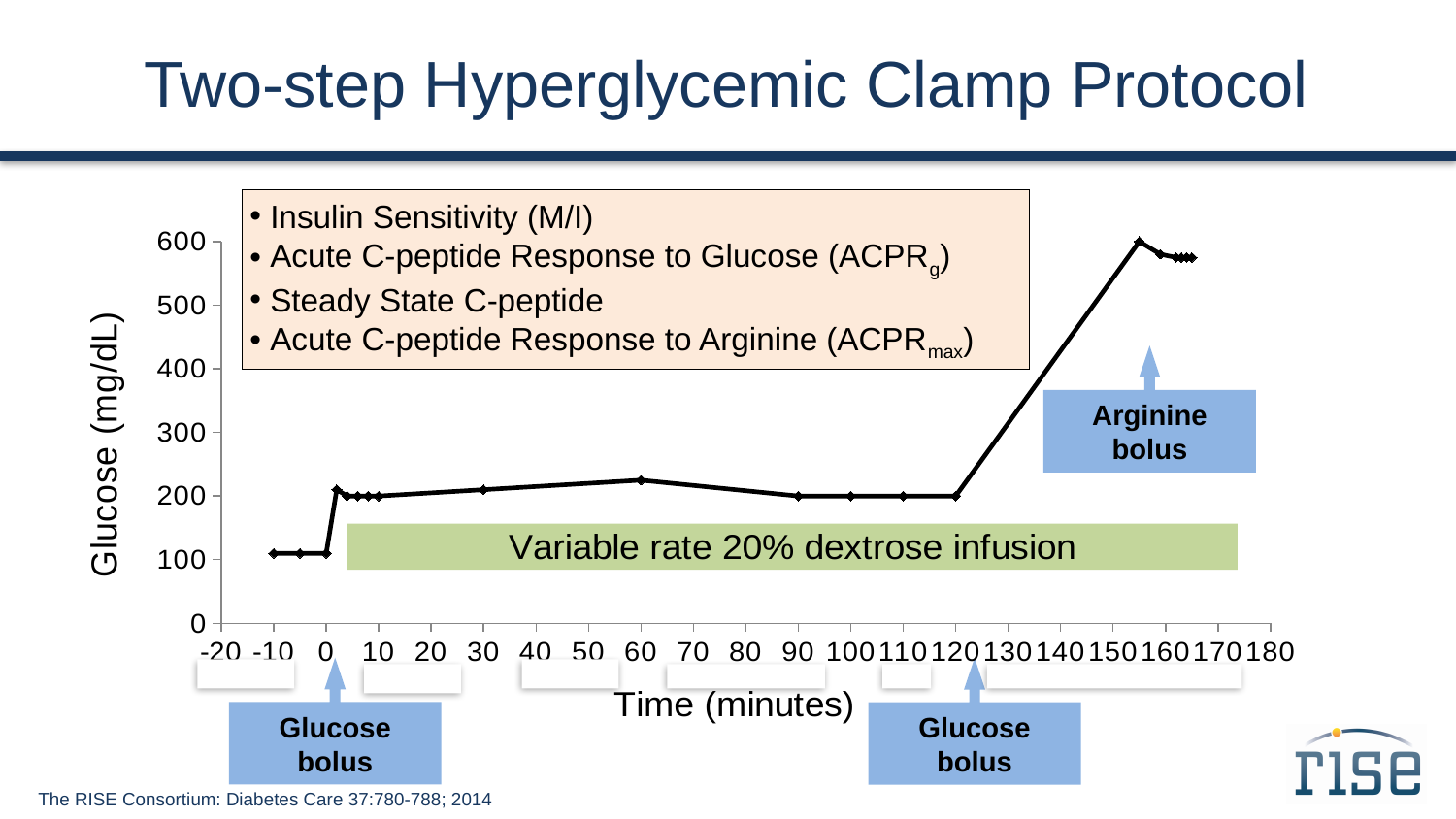
Is the glucose value at 60 minutes greater or less than 200? greater What kind of chart is shown on the slide? line chart What is the label of the y axis of the chart? Glucose (mg/dL) Which is higher, the glucose value at 150 minutes or at 120 minutes? 150 minutes Which is higher, the glucose value at 30 minutes or at -10 minutes? 30 minutes Is the glucose value at 120 minutes greater or less than 300? less What text is written in the green box inside the chart? Variable rate 20% dextrose infusion Is the glucose value at -10 minutes greater or less than 200? less Between 60 and 90 minutes, does the glucose value rise or fall? fall Between 120 and 150 minutes, does the glucose value rise or fall? rise